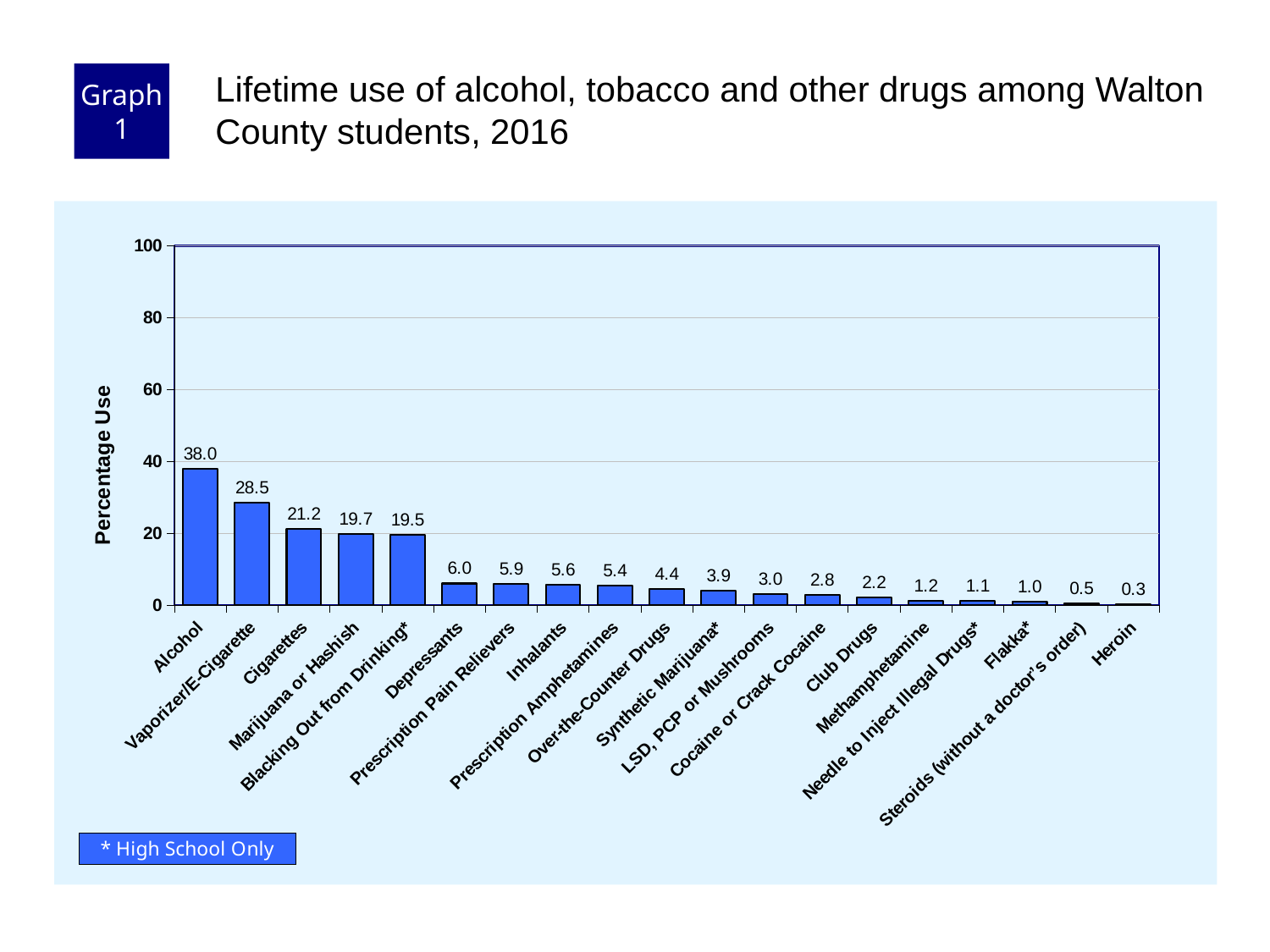
What is the difference in percentage use between Alcohol and Cigarettes? 16.8 Which has a higher percentage use, Depressants or Inhalants? Depressants What is the percentage use for Vaporizer/E-Cigarette? 28.5 What is the percentage use for Alcohol? 38.0 How many categories are shown on the x axis? 19 What is the label of the y axis? Percentage Use What is the percentage use for Heroin? 0.3 What kind of chart is shown on the slide? Bar chart Which category has the lowest percentage use? Heroin Which category has the highest percentage use? Alcohol Is the value for Vaporizer/E-Cigarette greater or less than 20? greater What is the percentage use for Marijuana or Hashish? 19.7